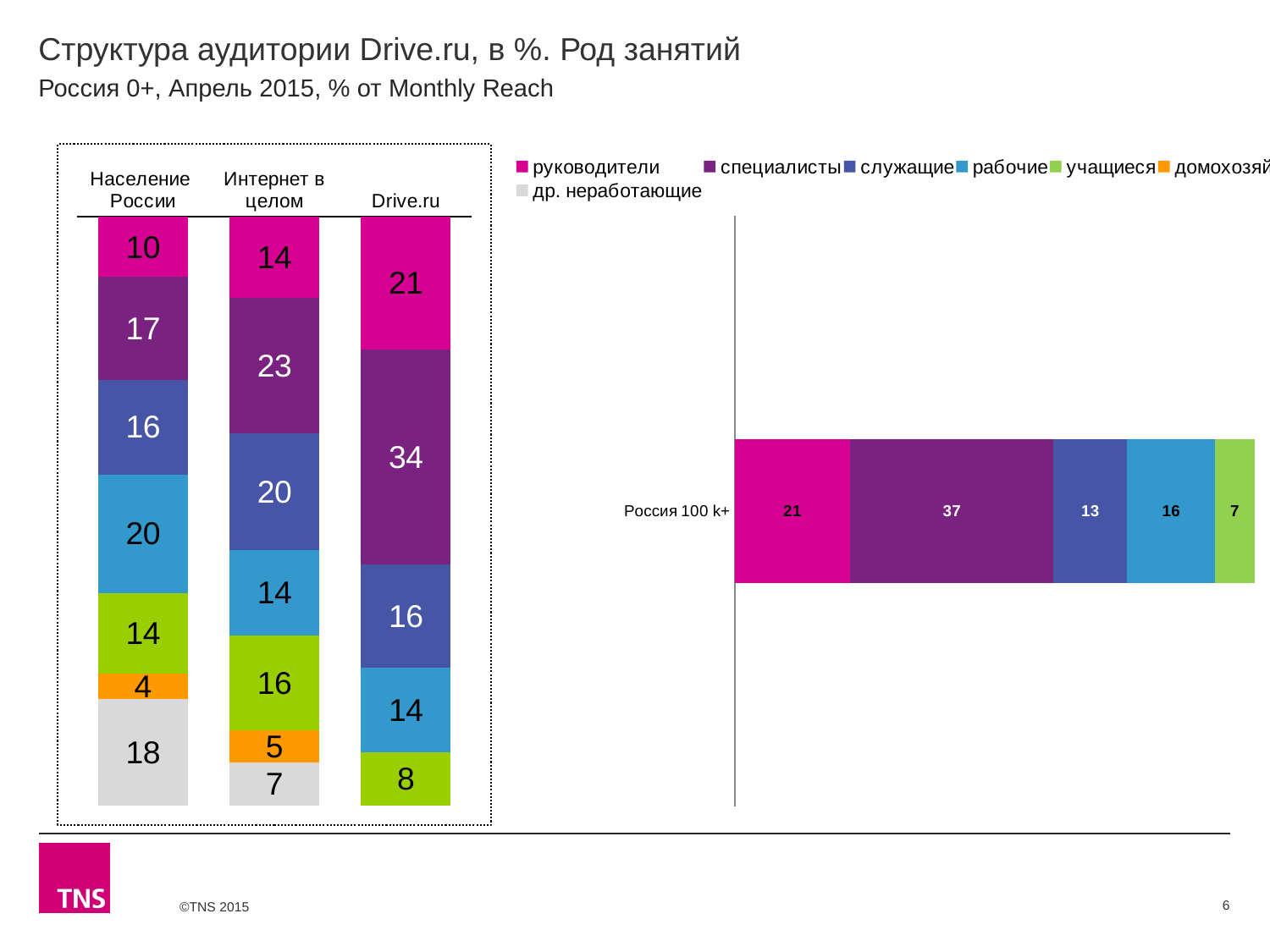
How many columns (categories) does the left chart show? 3 In the left chart, what is the difference between the руководители values for Drive.ru and Население России? 11 In the left chart, which is larger: рабочие for Население России or рабочие for Drive.ru? Население России In the left chart, what is the value for учащиеся in the Интернет в целом column? 16 In the left chart, what is the value for руководители in the Население России column? 10 In the left chart, what is the value for специалисты in the Drive.ru column? 34 What type of chart is the right chart? stacked bar chart In the right chart, what is the value for служащие for Россия 100 k+? 13 In the left chart, which segment is the largest in the Drive.ru column? специалисты How many series does the legend list? 7 In the right chart, what is the value for специалисты for Россия 100 k+? 37 In the left chart, which segment is the smallest in the Население России column? домохозяйки